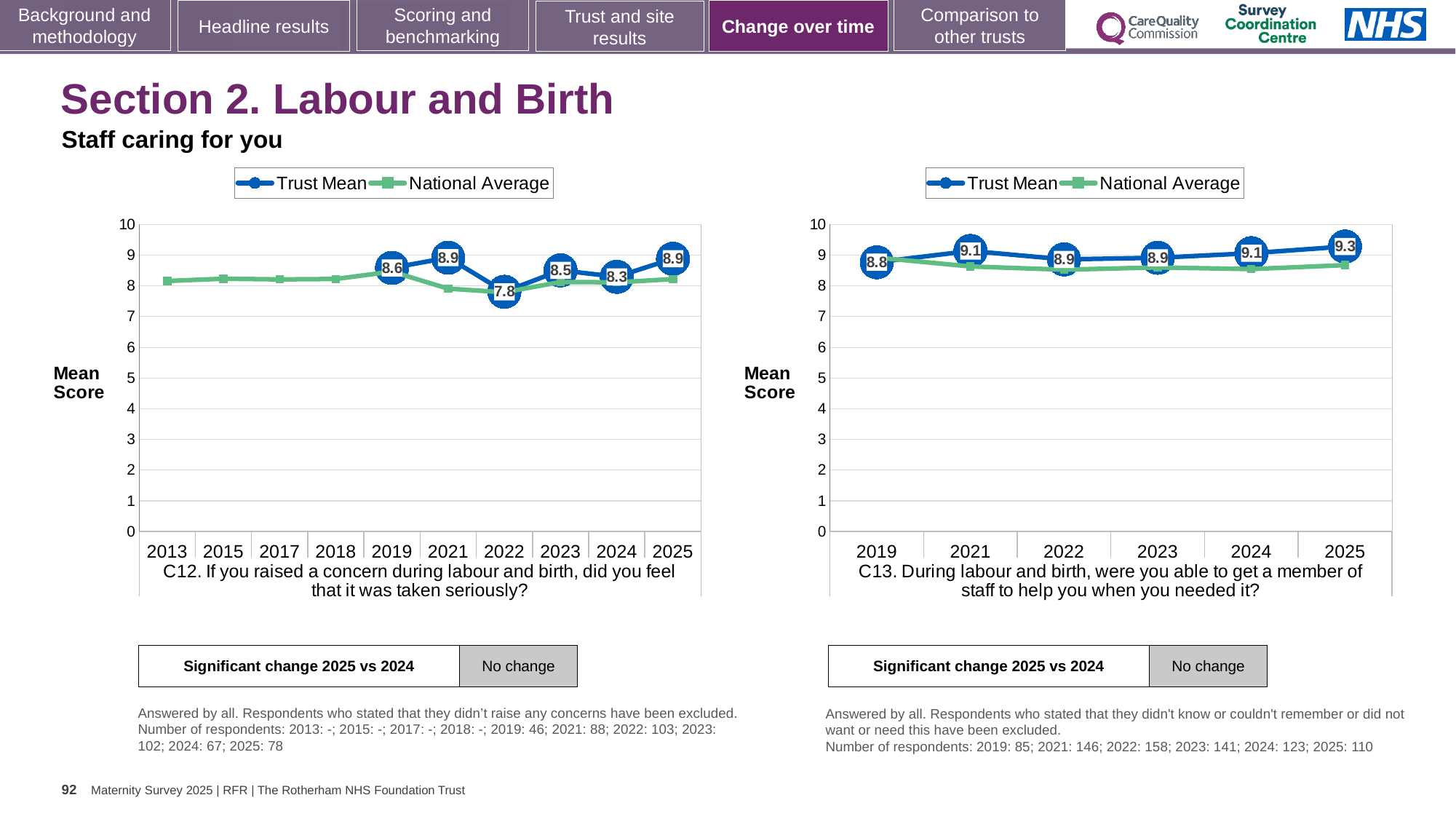
In the C13 chart on the right, which year has the highest Trust Mean value? 2025 In the C12 chart on the left, which is larger, the Trust Mean for 2023 or for 2024? 2023 In the C13 chart on the right, what is the difference between the Trust Mean values for 2025 and 2019? 0.5 In the C12 chart on the left, what is the Trust Mean value for 2025? 8.9 In the C12 chart on the left, which year has the lowest Trust Mean value? 2022 In the C12 chart on the left, what is the difference between the Trust Mean values for 2021 and 2022? 1.1 What kind of chart is the C13 chart on the right? Line chart In the C13 chart on the right, what is the Trust Mean value for 2019? 8.8 How many series does the legend of the C12 chart on the left list? 2 In the C12 chart on the left, what is the Trust Mean value for 2022? 7.8 In the C12 chart on the left, is the National Average value for 2013 greater or less than 9? less How many years are shown on the x axis of the C13 chart on the right? 6